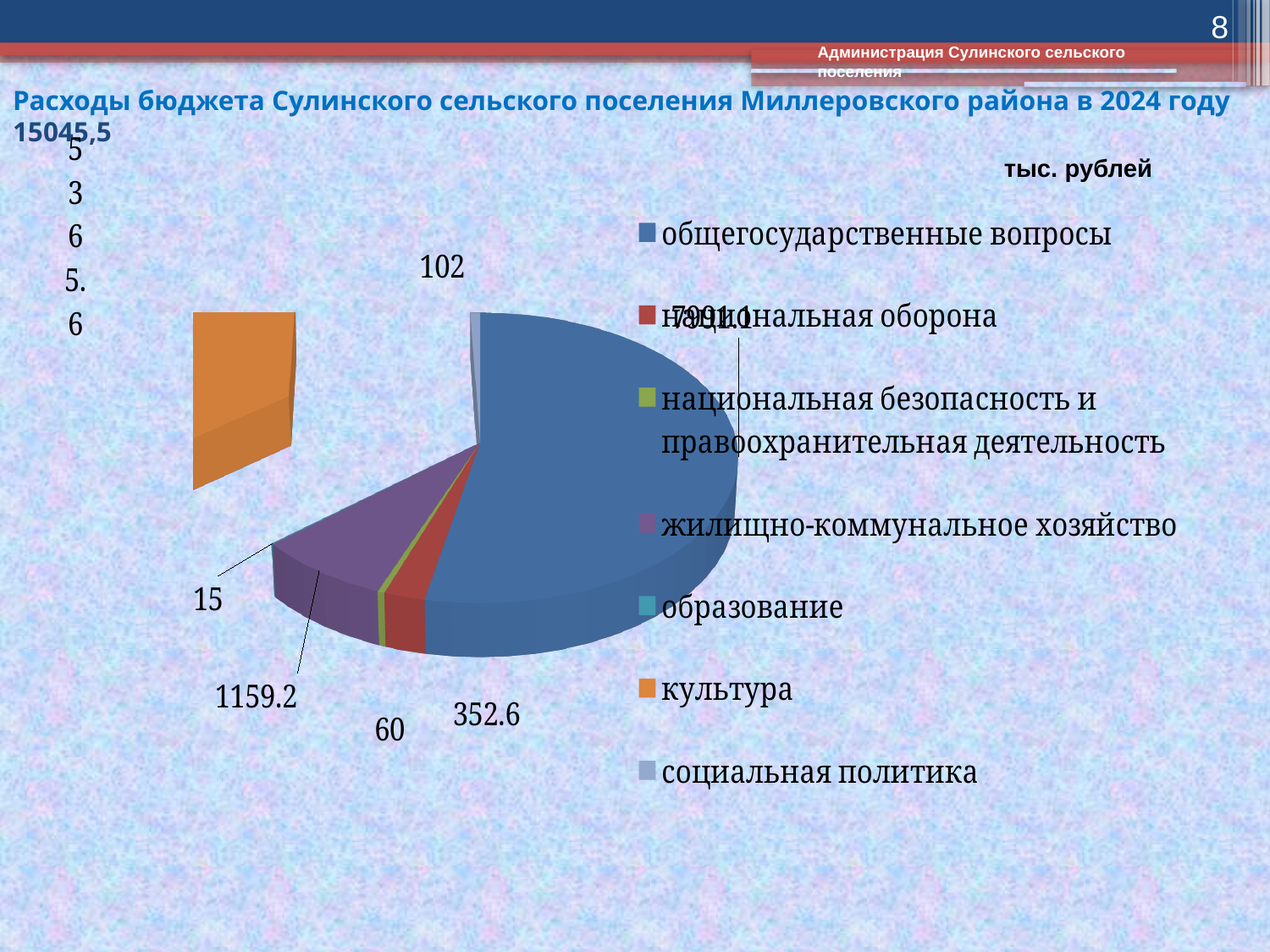
What is the value shown for социальная политика? 102 What is the difference between the values for жилищно-коммунальное хозяйство and национальная оборона? 806.6 What is the value shown for общегосударственные вопросы? 7991.1 What is the value shown for культура? 5365.6 How many categories does the legend of the pie chart list? 7 Which category has the largest slice of the pie chart? общегосударственные вопросы Which category has the smallest slice of the pie chart? образование What is the value shown for жилищно-коммунальное хозяйство? 1159.2 What is the value shown for национальная оборона? 352.6 What kind of chart is shown on the slide? pie chart Which is larger, the value for жилищно-коммунальное хозяйство or the value for национальная оборона? жилищно-коммунальное хозяйство What colour is the slice for культура in the pie chart? orange